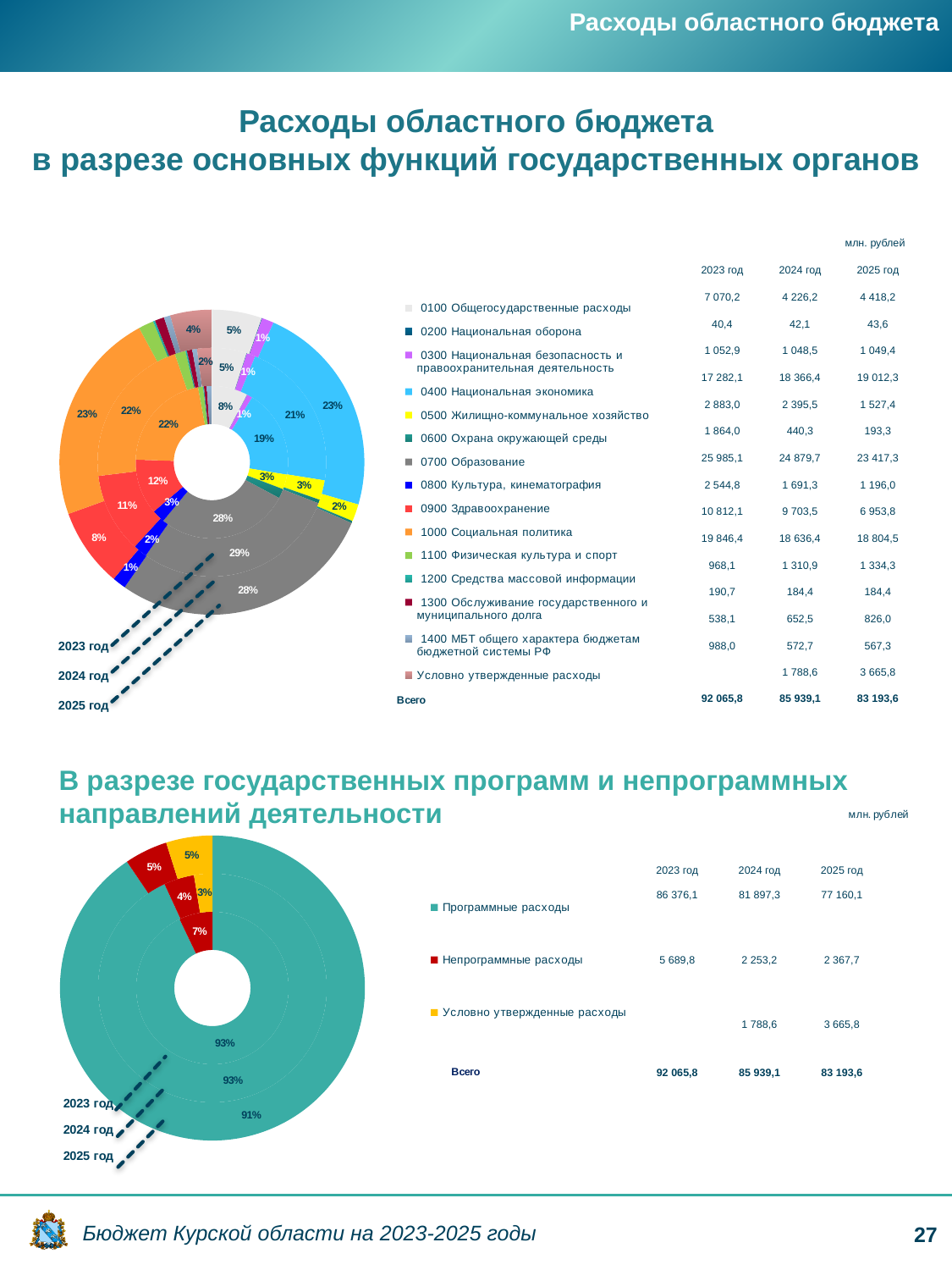
In the top chart's table, which category has the lowest value in 2023 год? 0200 Национальная оборона In the top chart's table, what is the Всего value for 2025 год? 83 193,6 In the top chart's table, which category has the highest value in 2023 год? 0700 Образование In the top chart's table, what is the value for 0400 Национальная экономика in 2024 год? 18 366,4 In the top chart's table, does the Всего value rise or fall from 2023 год to 2025 год? fall In the bottom chart's table, what is the value for Программные расходы in 2023 год? 86 376,1 In the bottom chart (В разрезе государственных программ и непрограммных направлений деятельности), what share do Непрограммные расходы have in 2023? 7% In the top chart's table, which is larger in 2023 год: 0900 Здравоохранение or 1000 Социальная политика? 1000 Социальная политика In the top chart's table, what is the difference between the Всего value for 2023 год and for 2025 год? 8 872,2 In the bottom chart (В разрезе государственных программ и непрограммных направлений деятельности), what share do Программные расходы have in 2025? 91% What kind of chart is used in the top chart on the slide (Расходы областного бюджета в разрезе основных функций государственных органов)? doughnut chart How many entries does the legend of the top chart list? 15